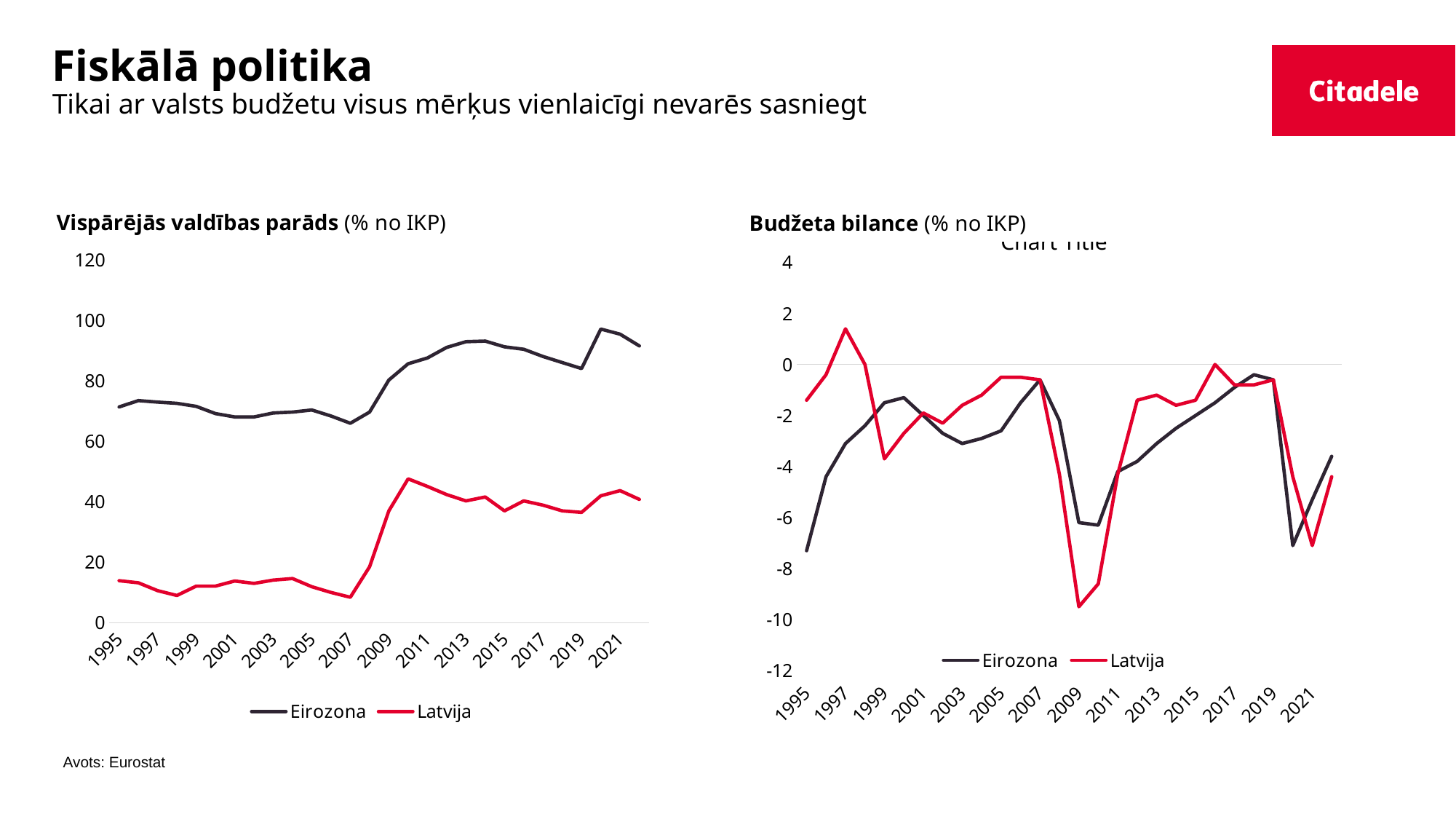
In the right chart 'Budžeta bilance', is the value for Latvija in 1997 greater or less than 0? greater In the left chart 'Vispārējās valdības parāds', is the value for Latvija in 2007 greater or less than 20? less In the right chart 'Budžeta bilance', is the value for Eirozona in 2009 greater or less than -4? less What colour is the Latvija line in the left chart 'Vispārējās valdības parāds'? red How many series does the legend of the right chart 'Budžeta bilance (% no IKP)' list? 2 In the left chart 'Vispārējās valdības parāds', which series has the higher value in 2021, Eirozona or Latvija? Eirozona In the left chart 'Vispārējās valdības parāds', does the Latvija line overall rise or fall from 1995 to 2021? rise What type of chart is the left chart titled 'Vispārējās valdības parāds (% no IKP)'? line chart In the right chart 'Budžeta bilance', which series has the higher value in 2009, Eirozona or Latvija? Eirozona